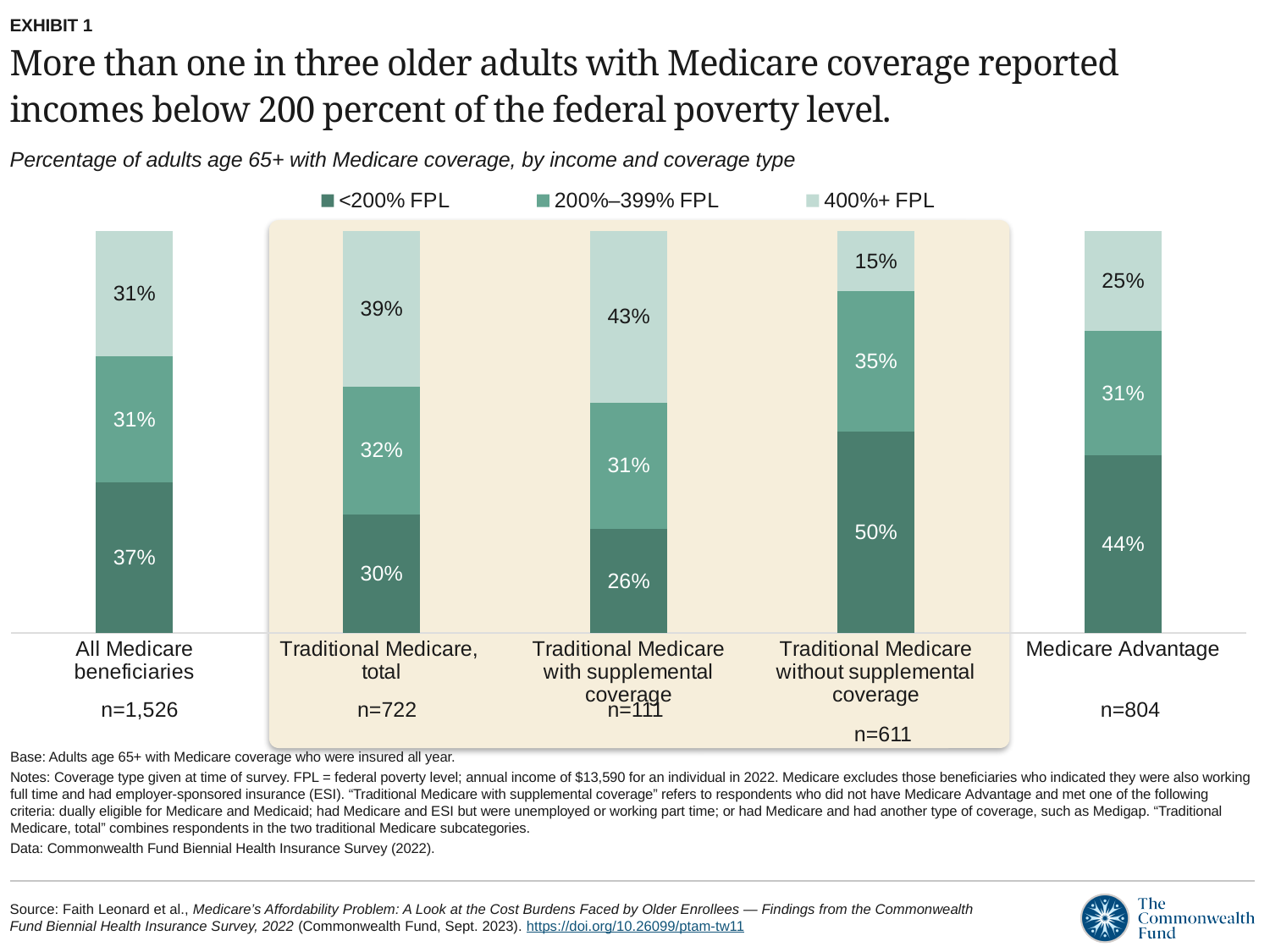
What is the 400%+ FPL value for Traditional Medicare with supplemental coverage? 43% Which is larger: the 400%+ FPL share for Traditional Medicare, total, or for Medicare Advantage? Traditional Medicare, total What kind of chart is shown on the slide? Stacked bar chart What is the difference between the <200% FPL share for Traditional Medicare without supplemental coverage and for Traditional Medicare with supplemental coverage? 24 percentage points Which income group is shown in the darkest green in the legend? <200% FPL What is the 200%–399% FPL value for Traditional Medicare without supplemental coverage? 35% How many series does the legend list? 3 What percentage of Medicare Advantage beneficiaries have incomes below 200% FPL? 44% Which coverage type has the lowest 400%+ FPL share? Traditional Medicare without supplemental coverage Which coverage type has the highest share of adults with incomes below 200% FPL? Traditional Medicare without supplemental coverage How many coverage-type categories are shown on the chart? 5 What is the sample size (n) for the All Medicare beneficiaries category? n=1,526